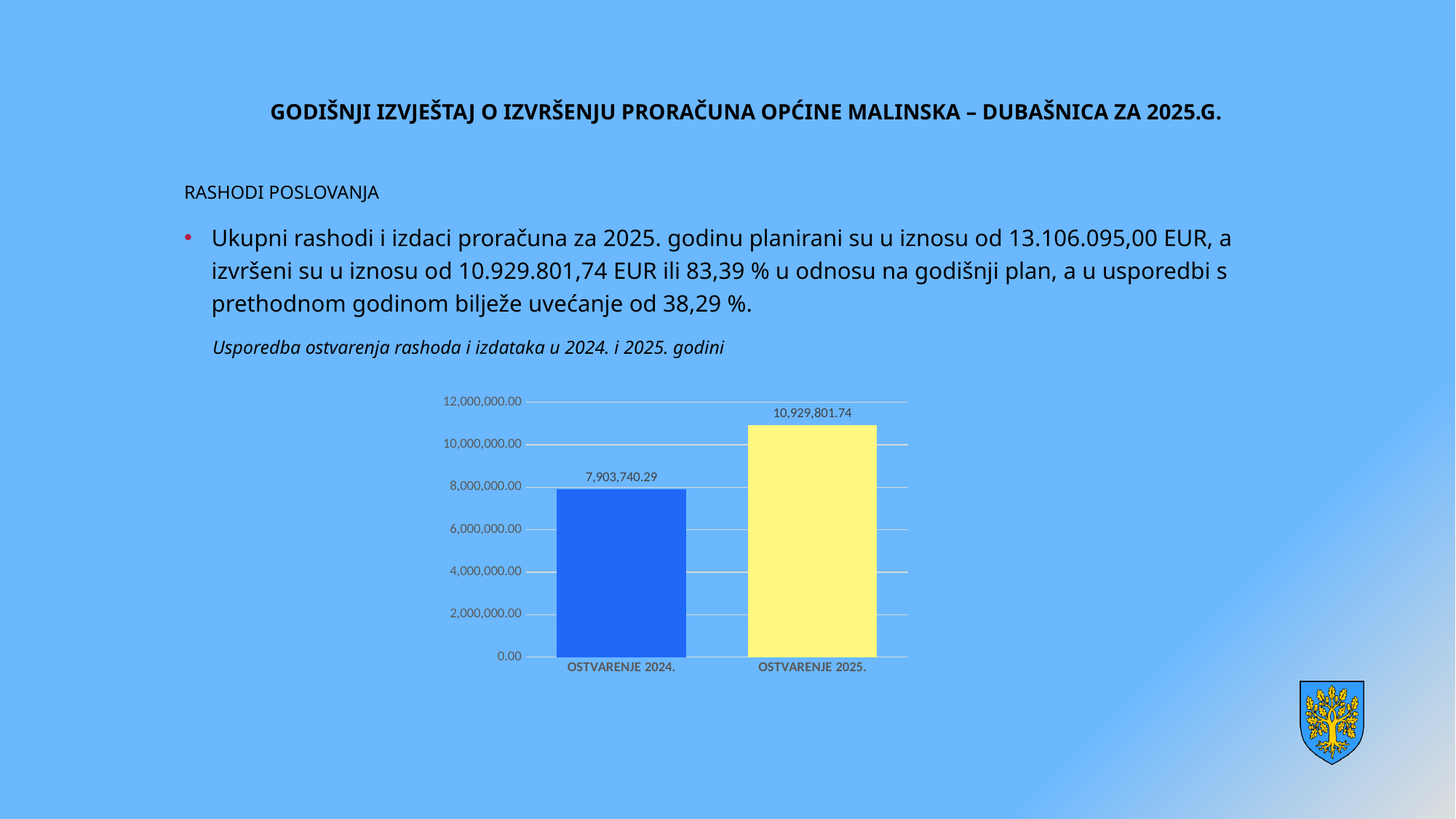
Is the value for OSTVARENJE 2024. greater or less than 8,000,000.00? less What is the value shown for OSTVARENJE 2025.? 10,929,801.74 What kind of chart is shown on the slide? bar chart What is the value shown for OSTVARENJE 2024.? 7,903,740.29 What colour is the bar for OSTVARENJE 2025.? yellow Is the value for OSTVARENJE 2025. greater or less than 10,000,000.00? greater Which category has the lowest value in the chart? OSTVARENJE 2024. Which category has the highest value in the chart? OSTVARENJE 2025. Which is larger, the value for OSTVARENJE 2024. or the value for OSTVARENJE 2025.? OSTVARENJE 2025. Do the values rise or fall from OSTVARENJE 2024. to OSTVARENJE 2025.? rise How many bars are plotted in the chart? 2 What is the difference between the values for OSTVARENJE 2025. and OSTVARENJE 2024.? 3,026,061.45